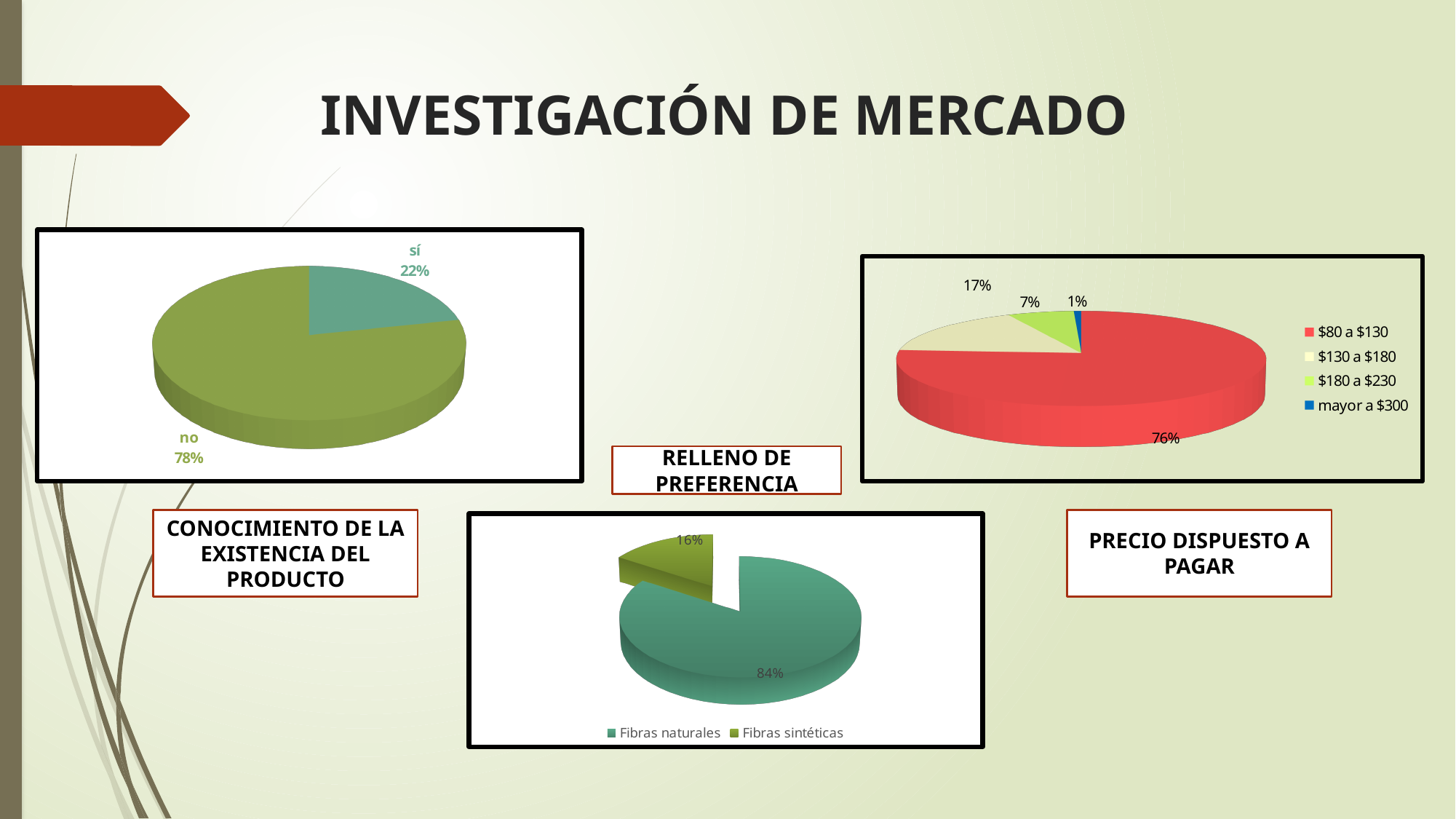
In the 'Conocimiento de la existencia del producto' chart, what percentage answered 'no'? 78% In the 'Precio dispuesto a pagar' chart, which category has the smallest share? mayor a $300 In the 'Precio dispuesto a pagar' chart, what is the difference between the '$180 a $230' and 'mayor a $300' shares? 6% How many categories does the legend of the 'Precio dispuesto a pagar' chart list? 4 In the 'Relleno de preferencia' chart, what is the share for 'Fibras naturales'? 84% In the 'Precio dispuesto a pagar' chart, what is the share for '$80 a $130'? 76% In the 'Conocimiento de la existencia del producto' chart, what percentage answered 'sí'? 22% In the 'Relleno de preferencia' chart, which category has the larger share, 'Fibras naturales' or 'Fibras sintéticas'? Fibras naturales In the 'Conocimiento de la existencia del producto' chart, what is the difference between the 'no' and 'sí' shares? 56% In the 'Relleno de preferencia' chart, what is the share for 'Fibras sintéticas'? 16% What kind of chart is the 'Relleno de preferencia' chart? Pie chart In the 'Precio dispuesto a pagar' chart, what is the share for '$130 a $180'? 17%